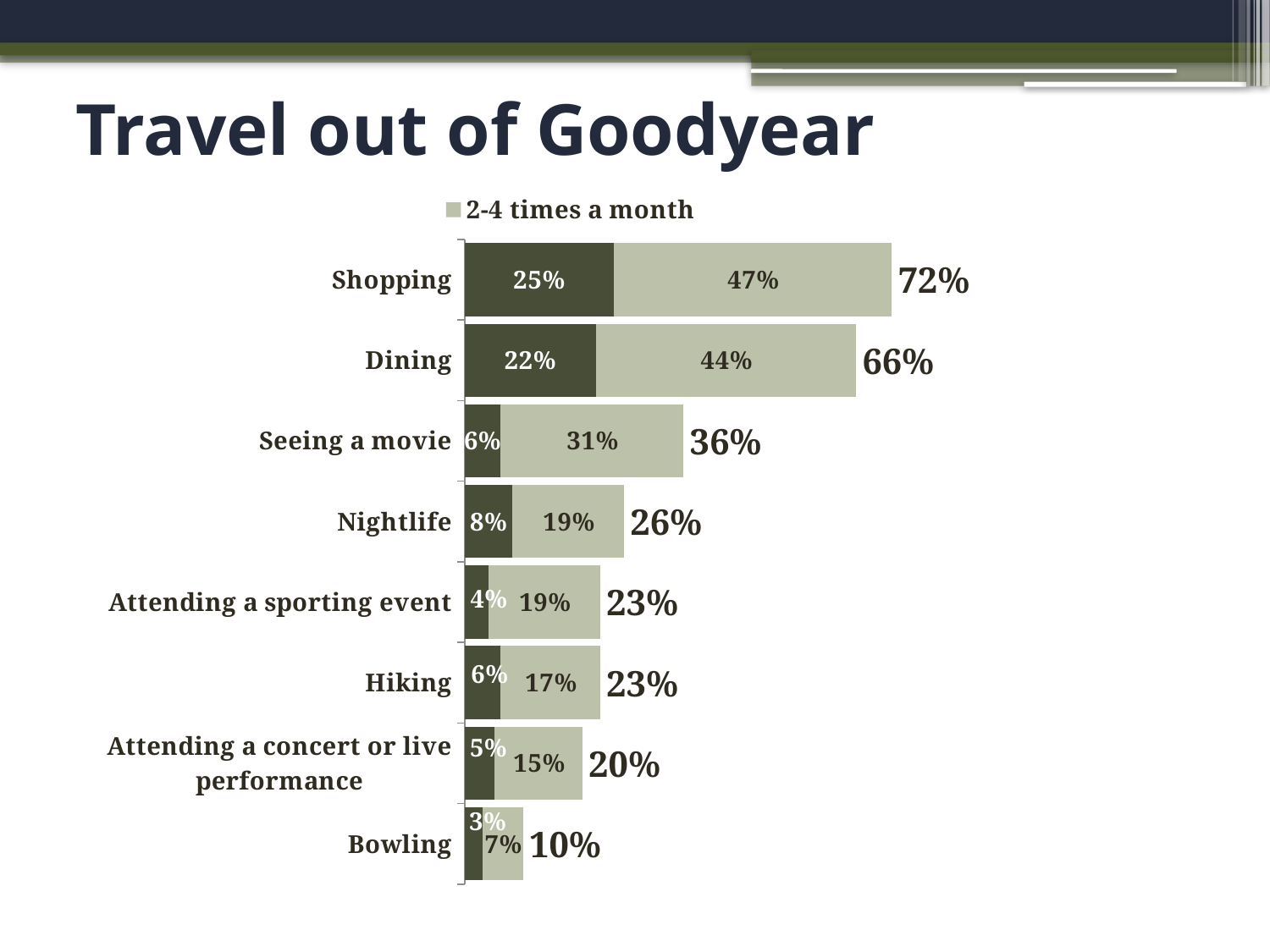
What is the difference between the Shopping total and the Dining total? 6% Which activity has the lowest total? Bowling What is the '2-4 times a month' value for Shopping? 47% What is the total shown for the Shopping bar? 72% Which activity has the highest total? Shopping What value is shown in the dark green segment for Dining? 22% Which has the larger total, Seeing a movie or Nightlife? Seeing a movie How many activity categories are plotted in the chart? 8 What entry does the legend show? 2-4 times a month What is the '2-4 times a month' value for Hiking? 17% What kind of chart is shown on the slide? Stacked bar chart What is the total shown for the Bowling bar? 10%